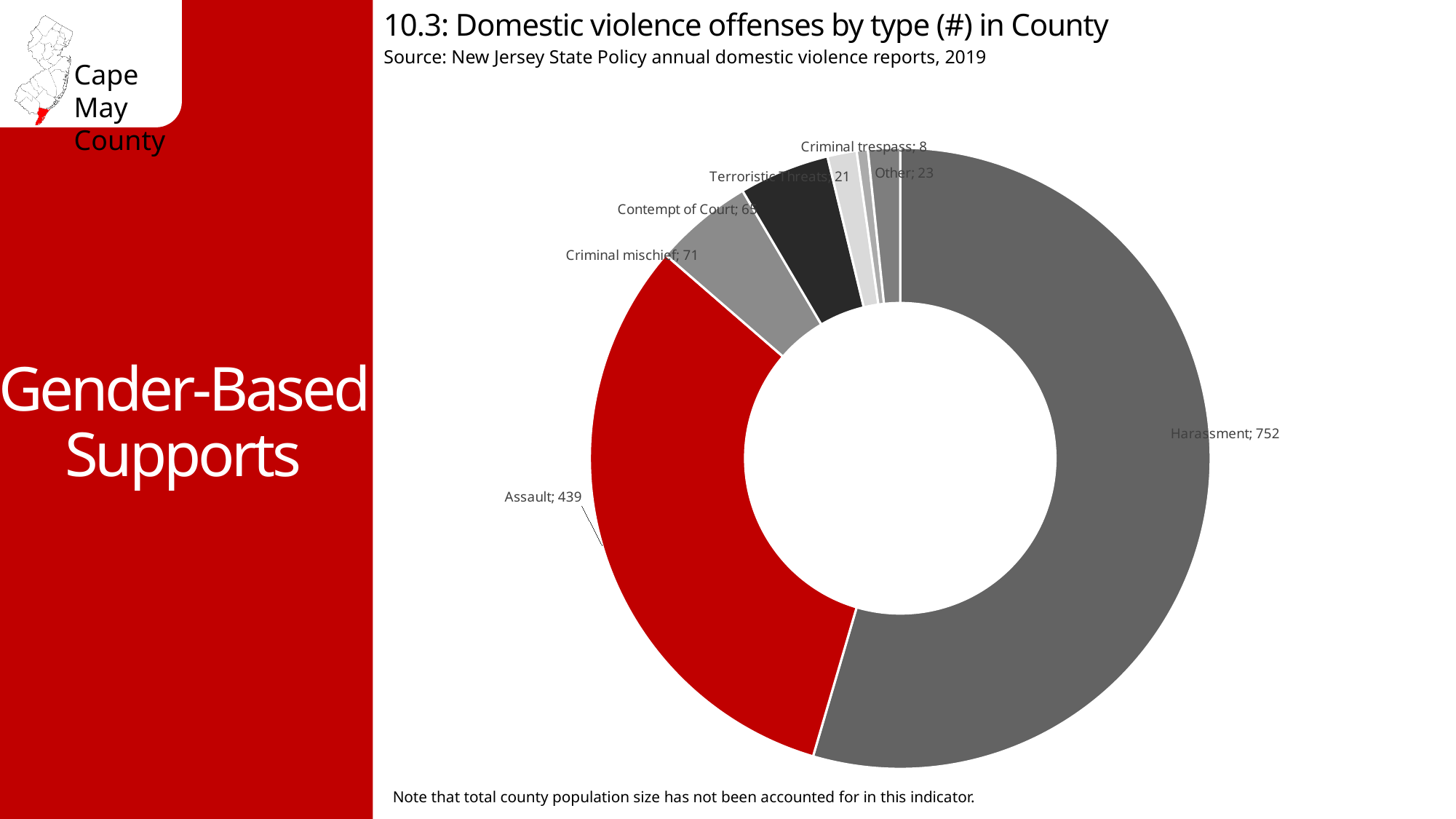
What kind of chart is shown on the slide? doughnut chart What is the number of Assault offenses shown in the chart? 439 What is the value for Criminal mischief? 71 Which offense type has the lowest number of offenses? Criminal trespass Which is larger, Criminal mischief or Terroristic Threats? Criminal mischief What is the value for Terroristic Threats? 21 Which offense type has the highest number of offenses? Harassment What is the difference between the Harassment and Assault values? 313 What is the value for the Other category? 23 What is the number of Harassment offenses shown in the chart? 752 How many offense categories are shown in the chart? 7 What is the value for Criminal trespass? 8